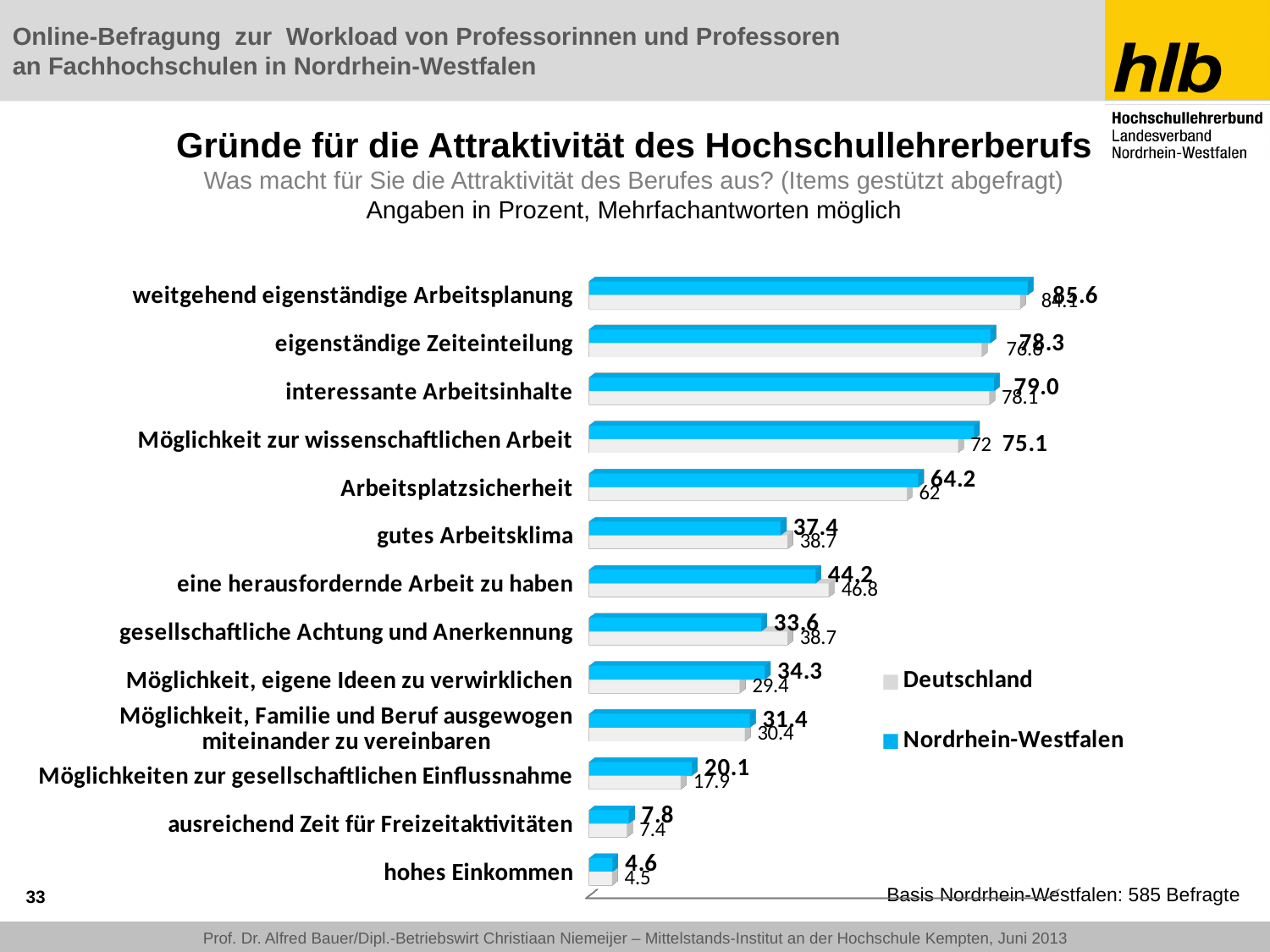
Which category has the lowest Nordrhein-Westfalen value? hohes Einkommen How many categories (reasons) are plotted in the chart? 13 For "Arbeitsplatzsicherheit", what is the difference between the Nordrhein-Westfalen value and the Deutschland value? 2.2 What is the Nordrhein-Westfalen value for "Arbeitsplatzsicherheit"? 64.2 How many series does the legend list? 2 What is the Nordrhein-Westfalen value for "Möglichkeiten zur gesellschaftlichen Einflussnahme"? 20.1 For "eine herausfordernde Arbeit zu haben", which series has the larger value, Deutschland or Nordrhein-Westfalen? Deutschland What kind of chart is shown on the slide? bar chart Which category has the highest Nordrhein-Westfalen value? weitgehend eigenständige Arbeitsplanung What is the Deutschland value for "Möglichkeit zur wissenschaftlichen Arbeit"? 72 What is the Deutschland value for "ausreichend Zeit für Freizeitaktivitäten"? 7.4 Which colour represents Nordrhein-Westfalen in the chart? blue